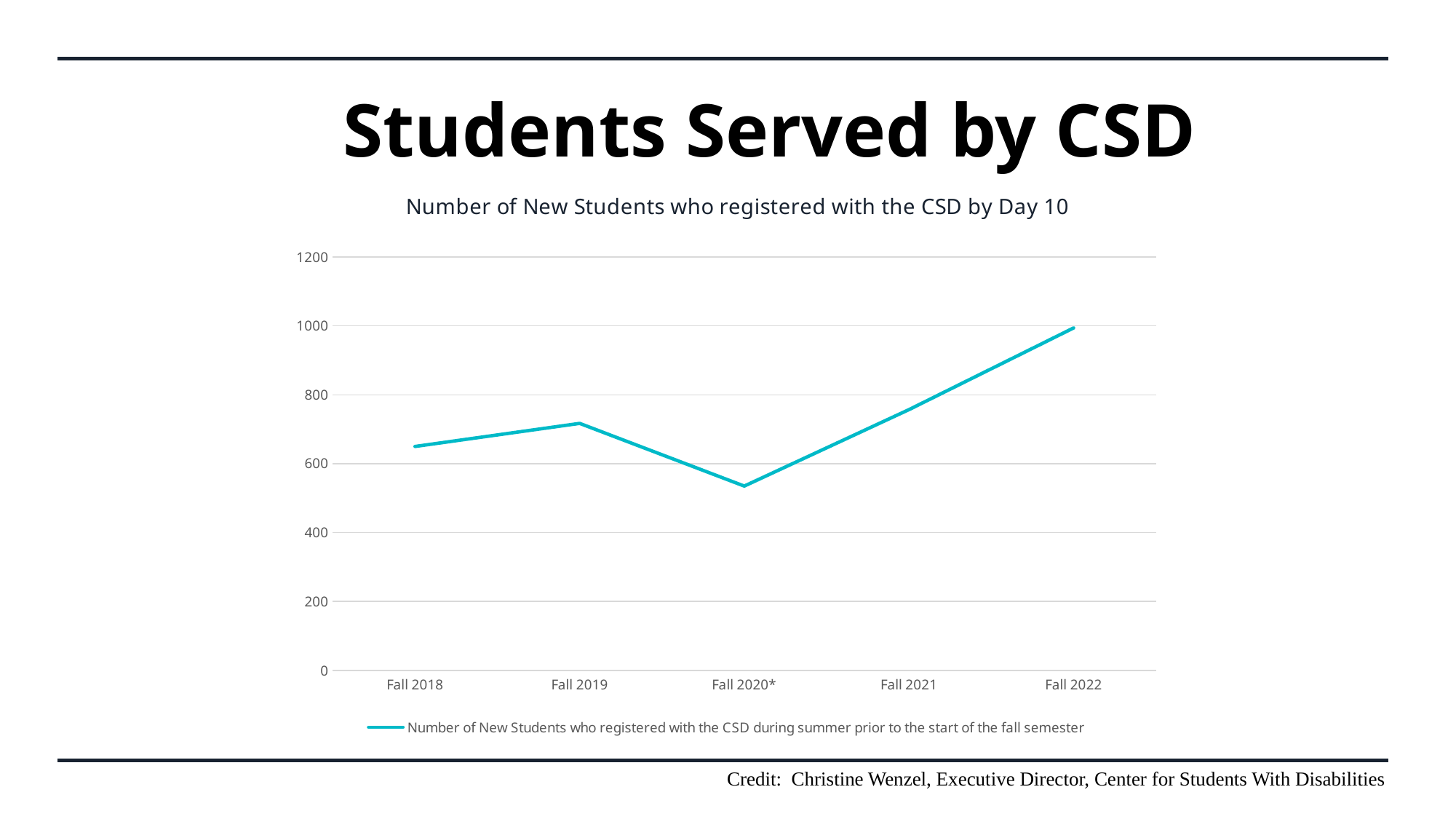
Is the value for Fall 2021 greater or less than 800? less Is the value for Fall 2022 greater or less than 800? greater Which semester has the highest number of new students registered with the CSD? Fall 2022 How many series does the legend list? 1 Between Fall 2020* and Fall 2022, do the values rise or fall? rise Is the value for Fall 2020* greater or less than 600? less What is the title of the chart? Number of New Students who registered with the CSD by Day 10 What kind of chart is shown on the slide? line chart How many data points are plotted on the line? 5 Which semester has the lowest number of new students registered with the CSD? Fall 2020* Which is larger, the value for Fall 2019 or the value for Fall 2018? Fall 2019